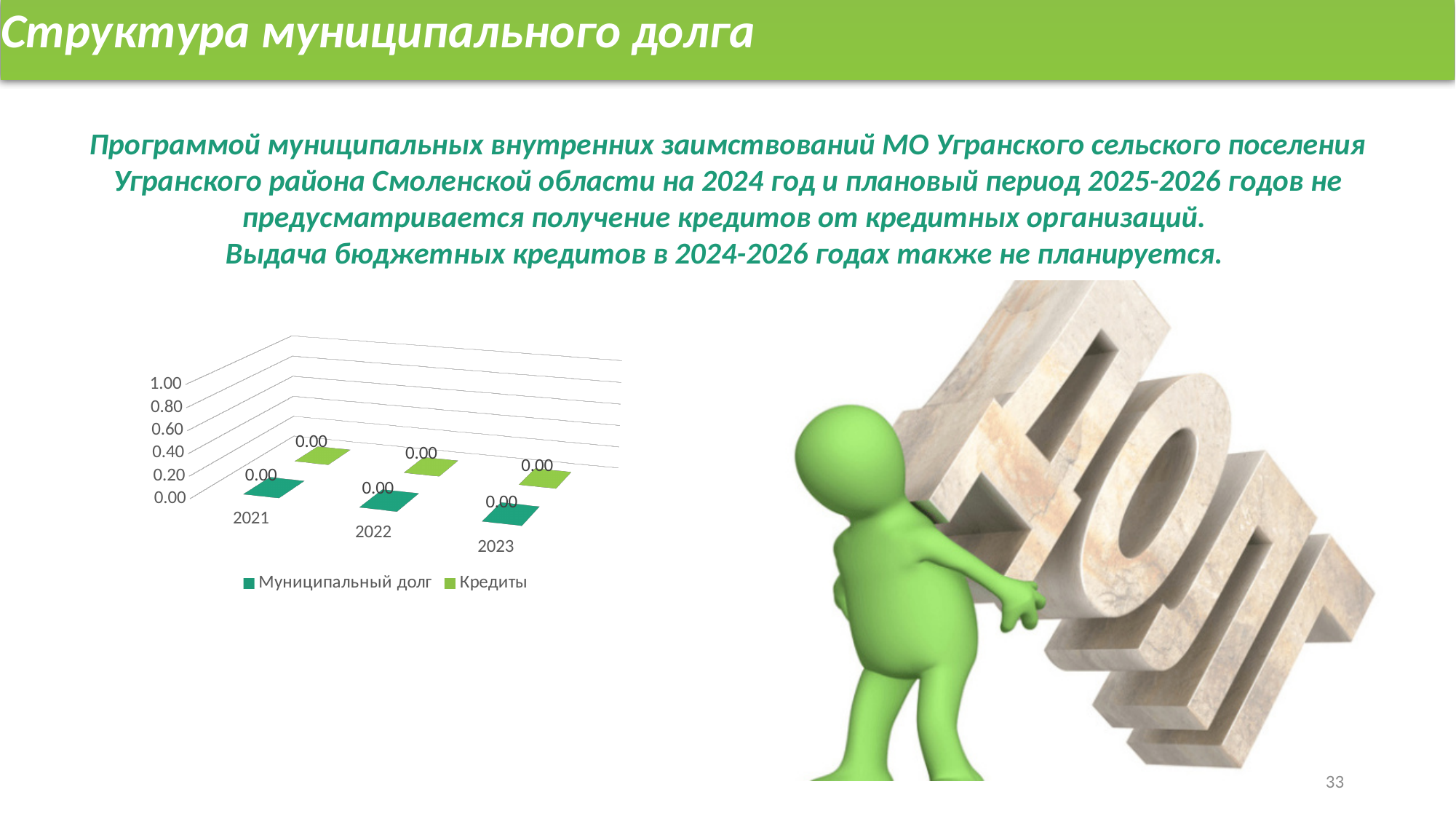
What are the two series named in the chart legend? Муниципальный долг and Кредиты What is the value for Кредиты in 2022? 0.00 How many years are shown on the x axis of the chart? 3 Do the values for Муниципальный долг rise, fall or stay the same from 2021 to 2023? stay the same What is the value for Кредиты in 2023? 0.00 What is the value for Муниципальный долг in 2023? 0.00 What kind of chart is shown on the slide? bar chart How many series does the chart legend list? 2 What is the highest tick value shown on the vertical axis of the chart? 1.00 What is the difference between the Муниципальный долг value in 2022 and the Кредиты value in 2022? 0.00 What is the value for Муниципальный долг in 2021? 0.00 Is the value for Кредиты in 2021 greater or less than 0.20? less